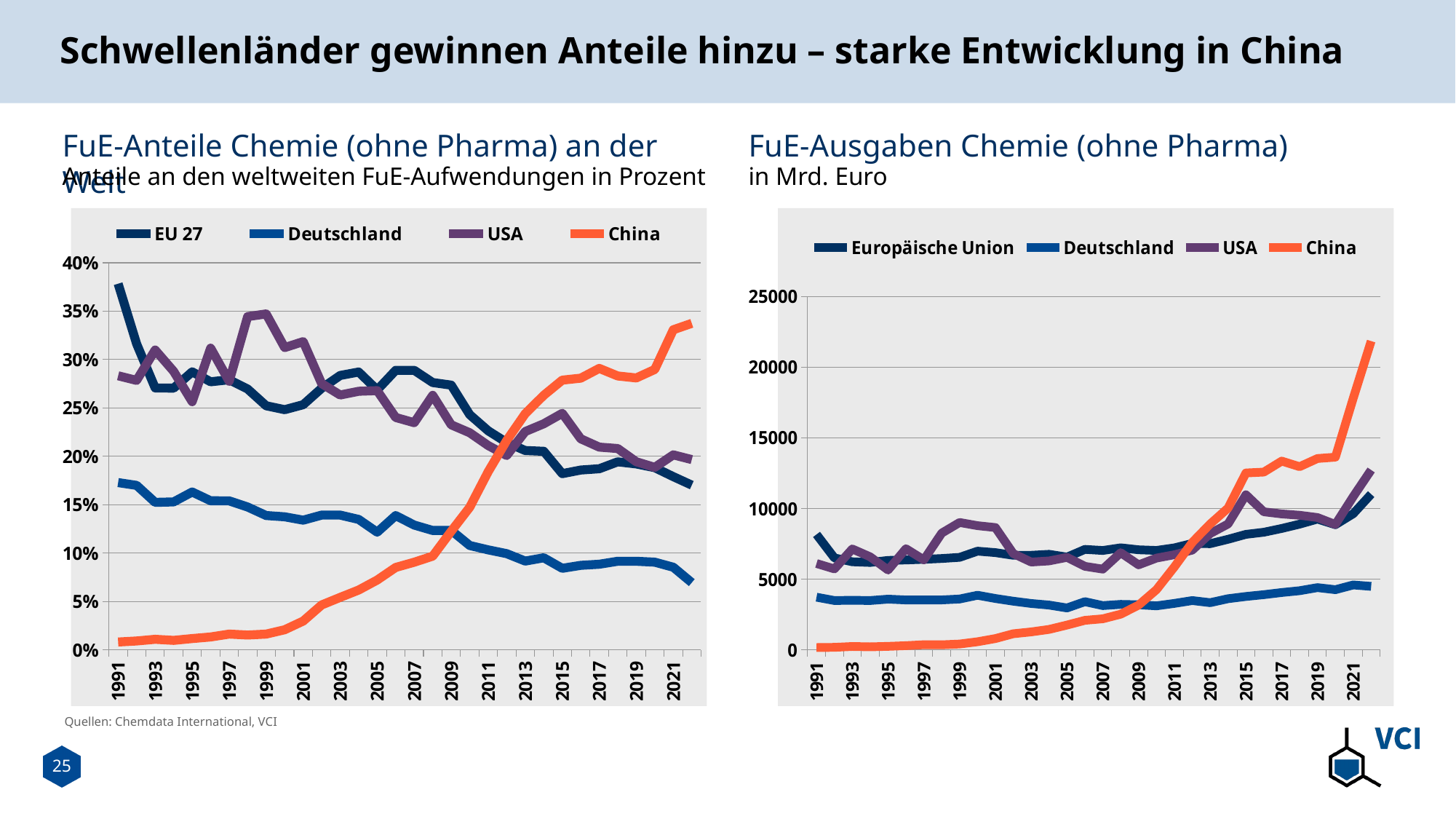
In the left chart, which series has the lowest value in 2021? Deutschland How many series does the legend of the right chart, 'FuE-Ausgaben Chemie (ohne Pharma)', list? 4 In the right chart, is the value for Deutschland in 1991 greater or less than 5000? less In the right chart, which series has the highest value at the end of the series? China In the left chart, is the value for China in 2021 greater or less than 30%? greater In the left chart, does the Deutschland line rise or fall from 1991 to the end of the series? fall In the left chart, does the China line rise or fall from 1991 to the end of the series? rise In the left chart, is the value for Deutschland in 1991 greater or less than 15%? greater How many series does the legend of the left chart list? 4 In the left chart, which is higher in 2021, China or USA? China What kind of chart is the left chart, 'FuE-Anteile Chemie (ohne Pharma) an der Welt'? line chart